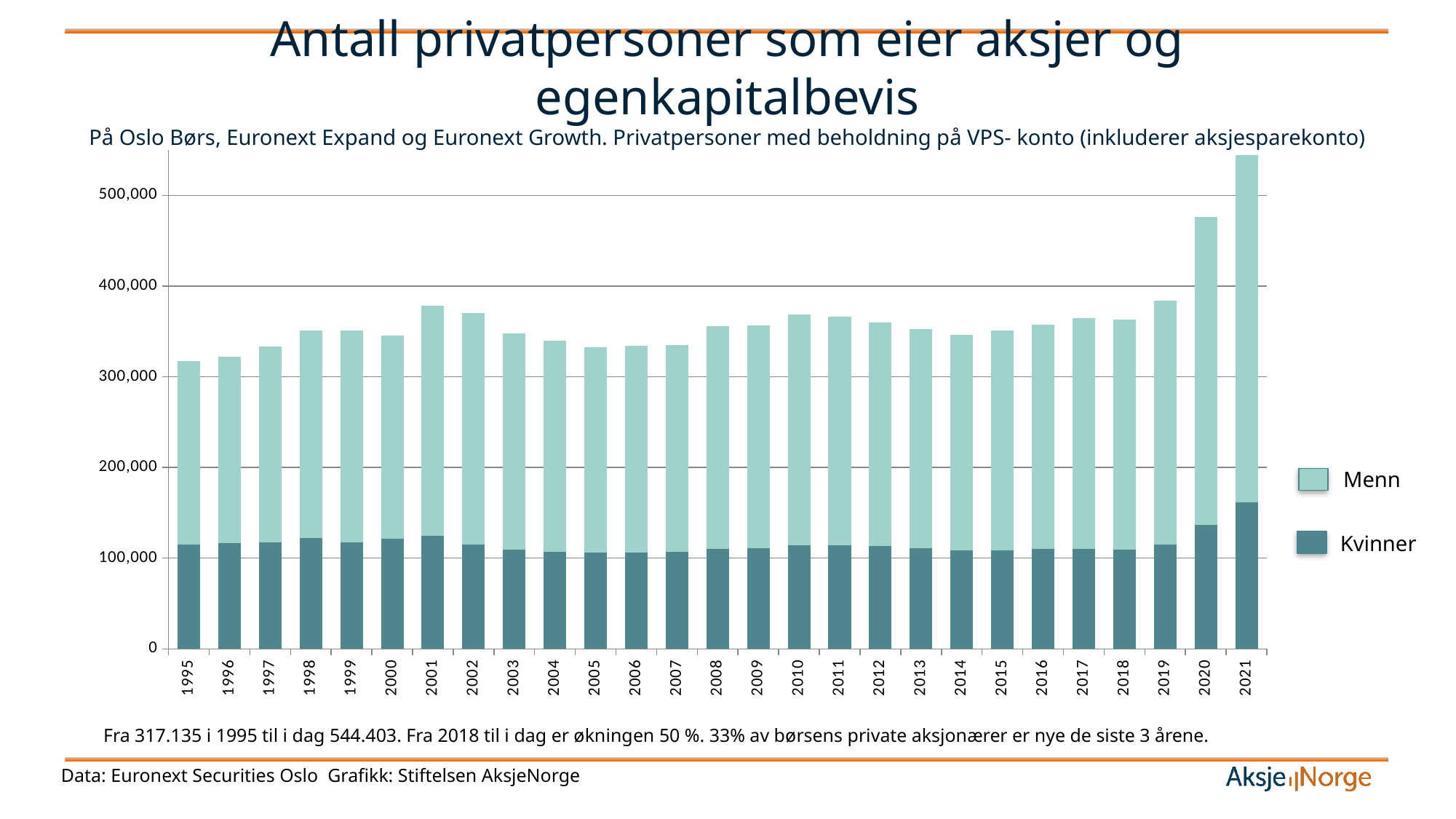
Is the total value for 2020 greater or less than 400,000? greater What kind of chart is shown on the slide? Stacked bar chart Is the total value for 2019 greater or less than 400,000? less How many series does the legend list? 2 Which two series are listed in the legend? Menn and Kvinner According to the text on the slide, what was the total number of private shareholders in 1995? 317.135 Which year has the lowest total number of private shareholders? 1995 According to the text on the slide, what is the total number of private shareholders today (2021)? 544.403 How many years are shown along the x axis? 27 Which year has the larger Kvinner value, 2020 or 2021? 2021 Which year has the highest total number of private shareholders? 2021 Do the total values rise or fall from 2018 to 2021? Rise